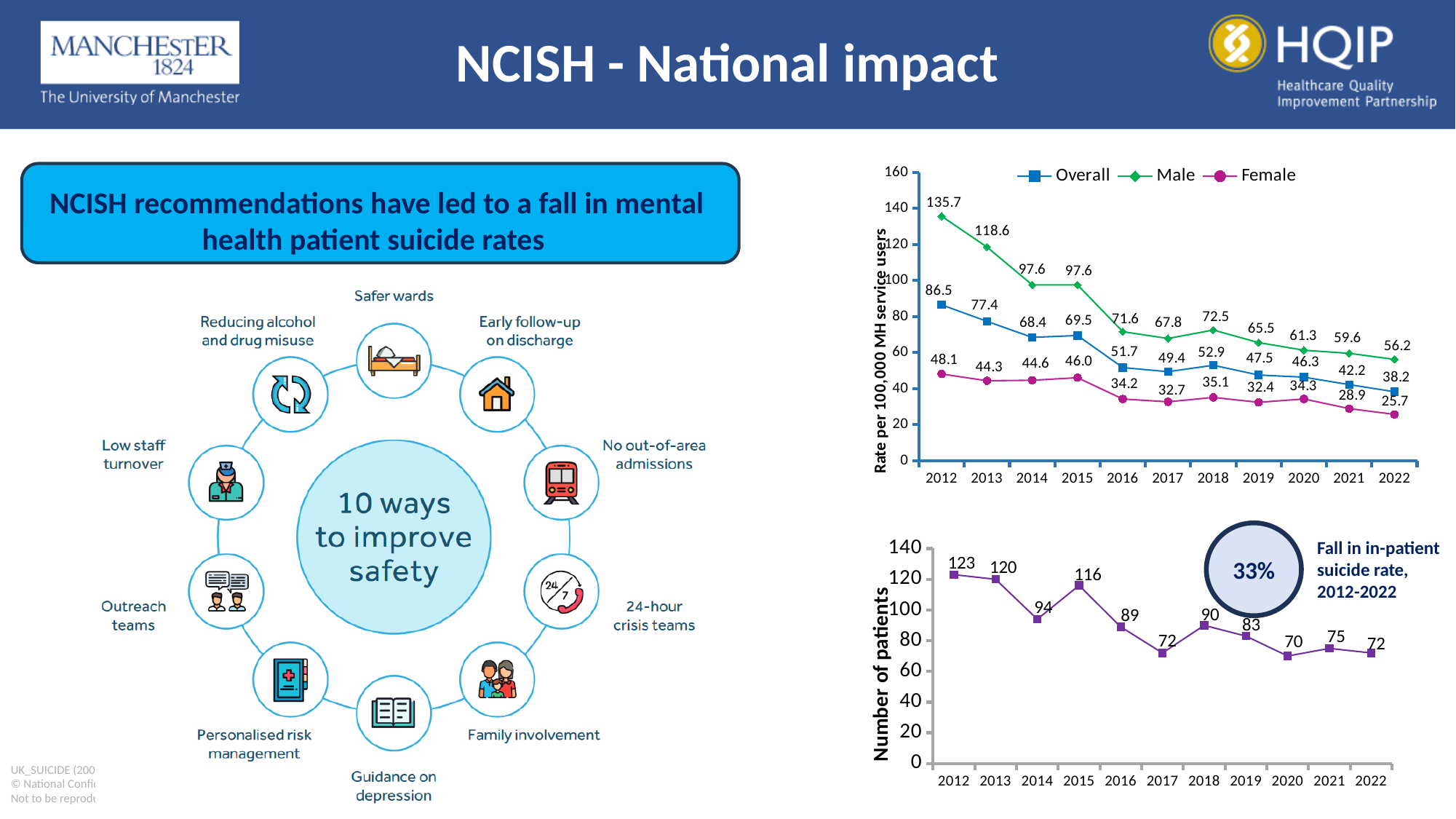
In the top-right line chart, what was the Overall rate in 2022? 38.2 In the bottom-right chart, how many years are plotted on the x axis? 11 In the top-right line chart, which year has the lowest Female rate? 2022 In the top-right line chart, what was the Male rate per 100,000 MH service users in 2012? 135.7 How many series does the legend of the top-right line chart list? 3 What type of chart is the bottom-right chart showing Number of patients? Line chart In the bottom-right chart, is the number of patients larger in 2014 or in 2018? 2014 In the top-right line chart, does the Male rate generally rise or fall from 2012 to 2022? Fall In the top-right line chart, what was the Female rate in 2016? 34.2 In the bottom-right chart, which year has the highest number of patients? 2012 In the bottom-right chart, what was the number of patients in 2015? 116 In the top-right line chart, what is the difference between the Male and Female rates in 2012? 87.6